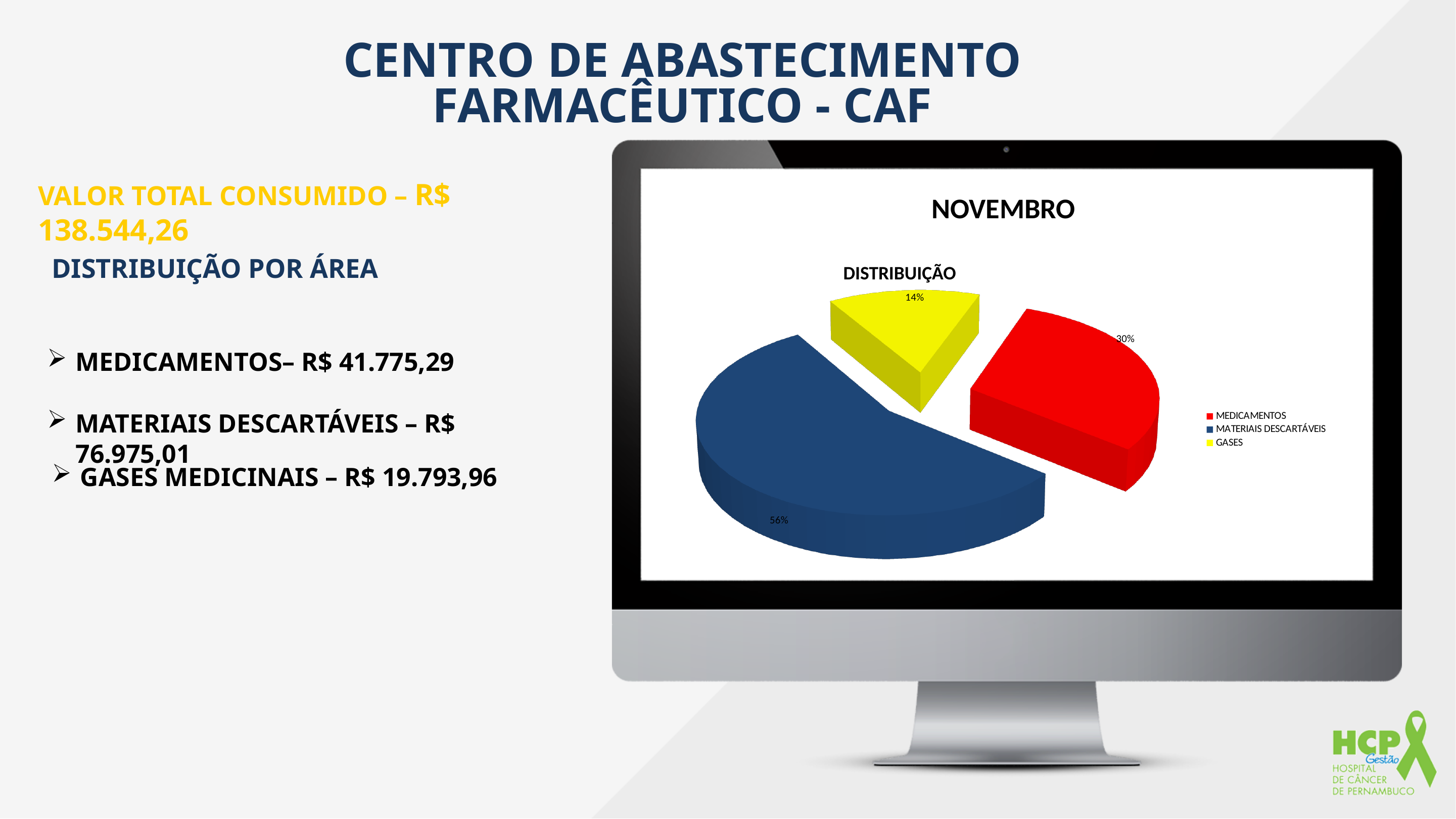
What kind of chart is shown on the slide? Pie chart What share of the pie does GASES represent? 14% Which slice is larger, MEDICAMENTOS or GASES? MEDICAMENTOS What colour is the GASES slice in the pie chart? Yellow By how many percentage points does the MATERIAIS DESCARTÁVEIS slice exceed the MEDICAMENTOS slice? 26 percentage points By how many percentage points does the MEDICAMENTOS slice exceed the GASES slice? 16 percentage points What share of the pie does MATERIAIS DESCARTÁVEIS represent? 56% How many entries does the chart legend list? 3 Which category has the largest slice of the pie? MATERIAIS DESCARTÁVEIS How many slices does the pie chart have? 3 What share of the pie does MEDICAMENTOS represent? 30% Which category has the smallest slice of the pie? GASES